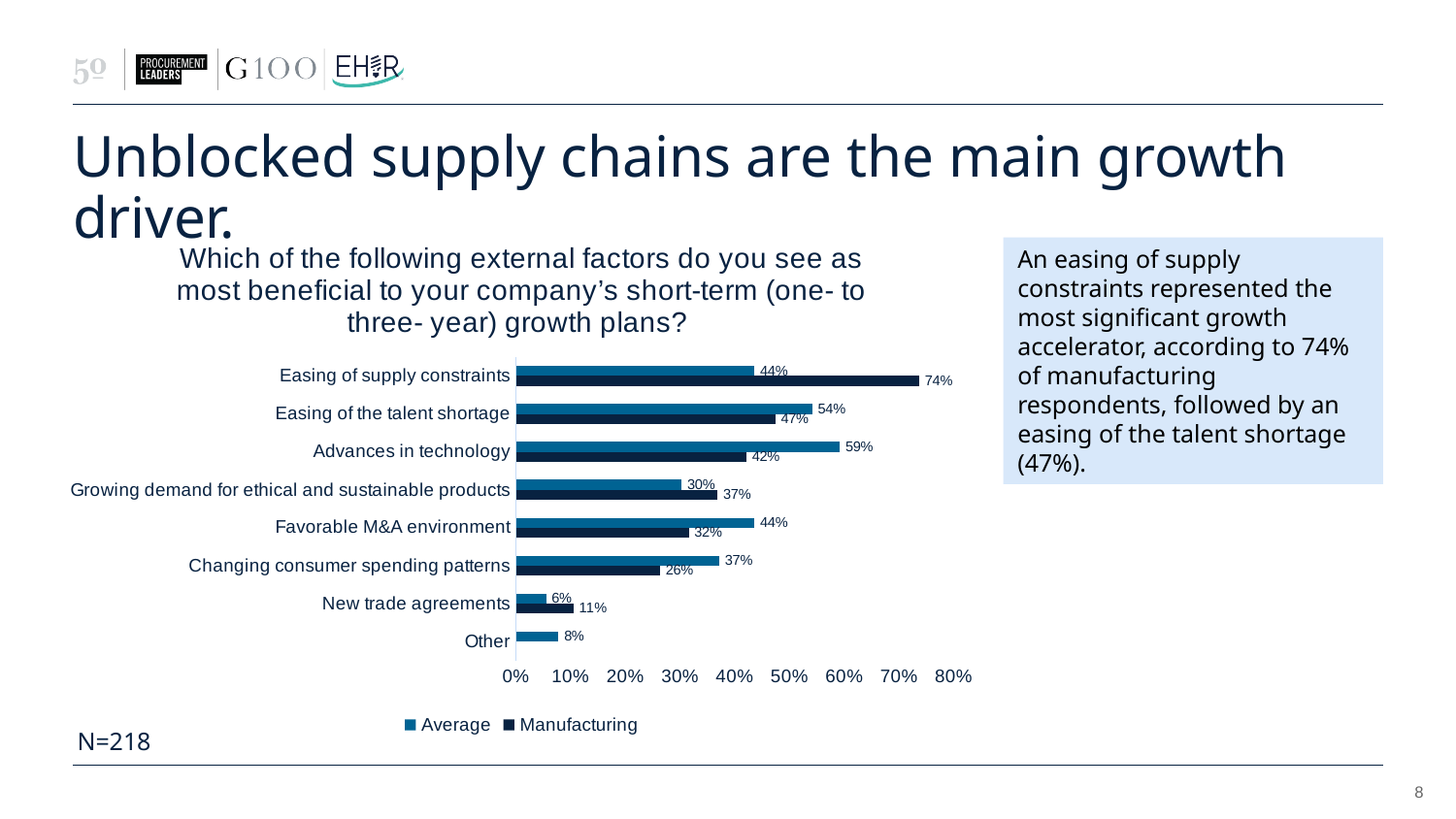
For Easing of the talent shortage, which is larger: the Average value or the Manufacturing value? Average What is the Manufacturing value for Changing consumer spending patterns? 26% What are the two series listed in the legend? Average and Manufacturing What kind of chart is shown on the slide? Bar chart What is the Average value for Advances in technology? 59% What is the Manufacturing value for Easing of supply constraints? 74% Which category has the lowest Average value? New trade agreements How many categories are shown on the chart? 8 What is the Average value for Other? 8% What is the difference between the Manufacturing and Average values for Easing of supply constraints? 30% How many series does the legend list? 2 Which category has the highest Manufacturing value? Easing of supply constraints